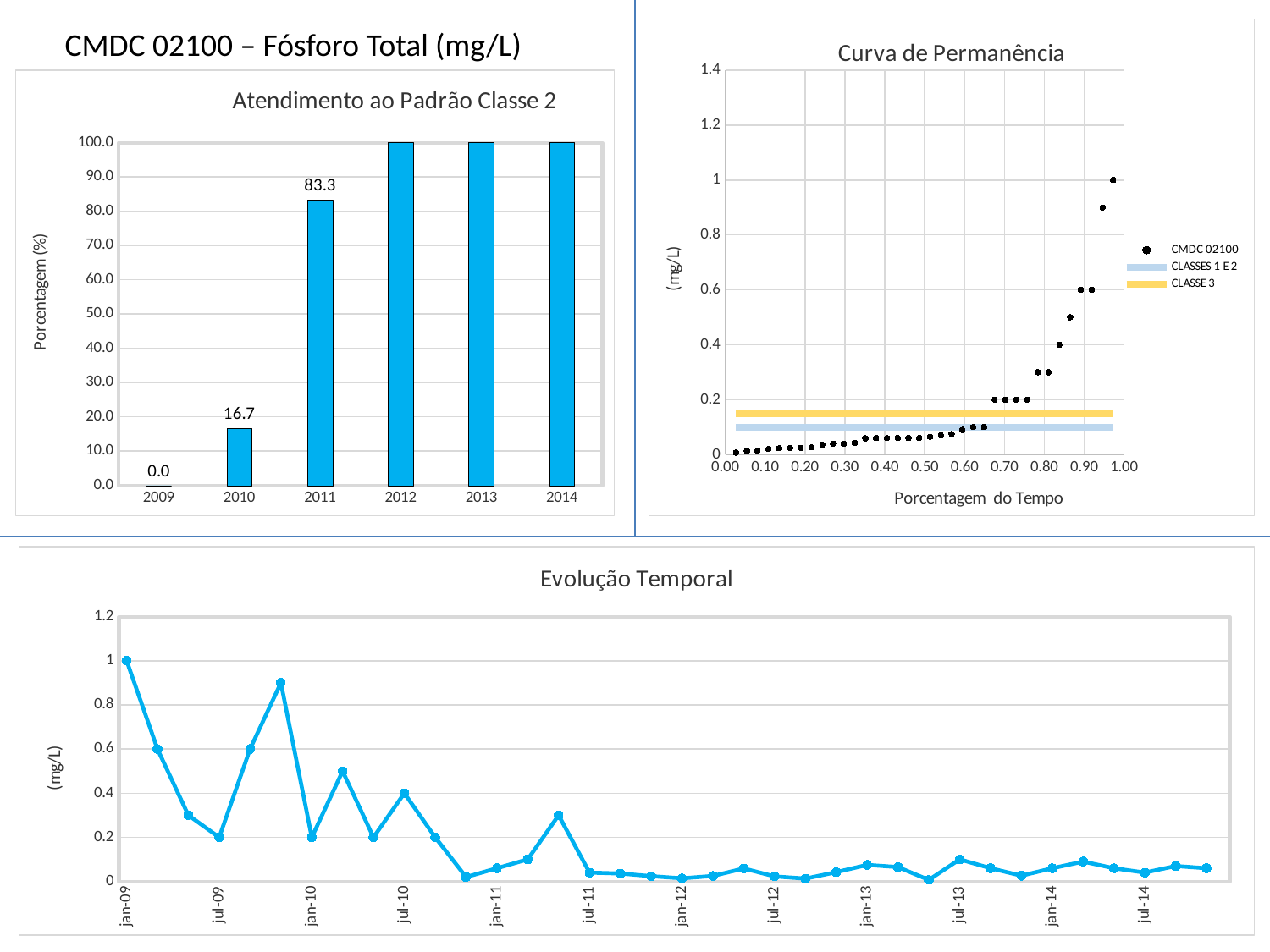
In the 'Atendimento ao Padrão Classe 2' chart, what is the difference between the values for 2011 and 2010? 66.6 In the 'Atendimento ao Padrão Classe 2' chart, what is the value for 2010? 16.7 What kind of chart is 'Atendimento ao Padrão Classe 2'? bar chart What is the y-axis label of the 'Evolução Temporal' chart? (mg/L) In the 'Atendimento ao Padrão Classe 2' chart, which is larger, the value for 2010 or the value for 2011? 2011 In the 'Atendimento ao Padrão Classe 2' chart, what is the value for 2009? 0.0 In the 'Evolução Temporal' chart, do the values generally rise or fall from jan-09 to jul-14? fall How many series does the legend of the 'Curva de Permanência' chart list? 3 In the 'Atendimento ao Padrão Classe 2' chart, what is the value for 2011? 83.3 In the 'Atendimento ao Padrão Classe 2' chart, is the value for 2012 greater or less than 90.0? greater In the 'Atendimento ao Padrão Classe 2' chart, which year has the lowest value? 2009 In the 'Atendimento ao Padrão Classe 2' chart, how many years are shown on the x axis? 6